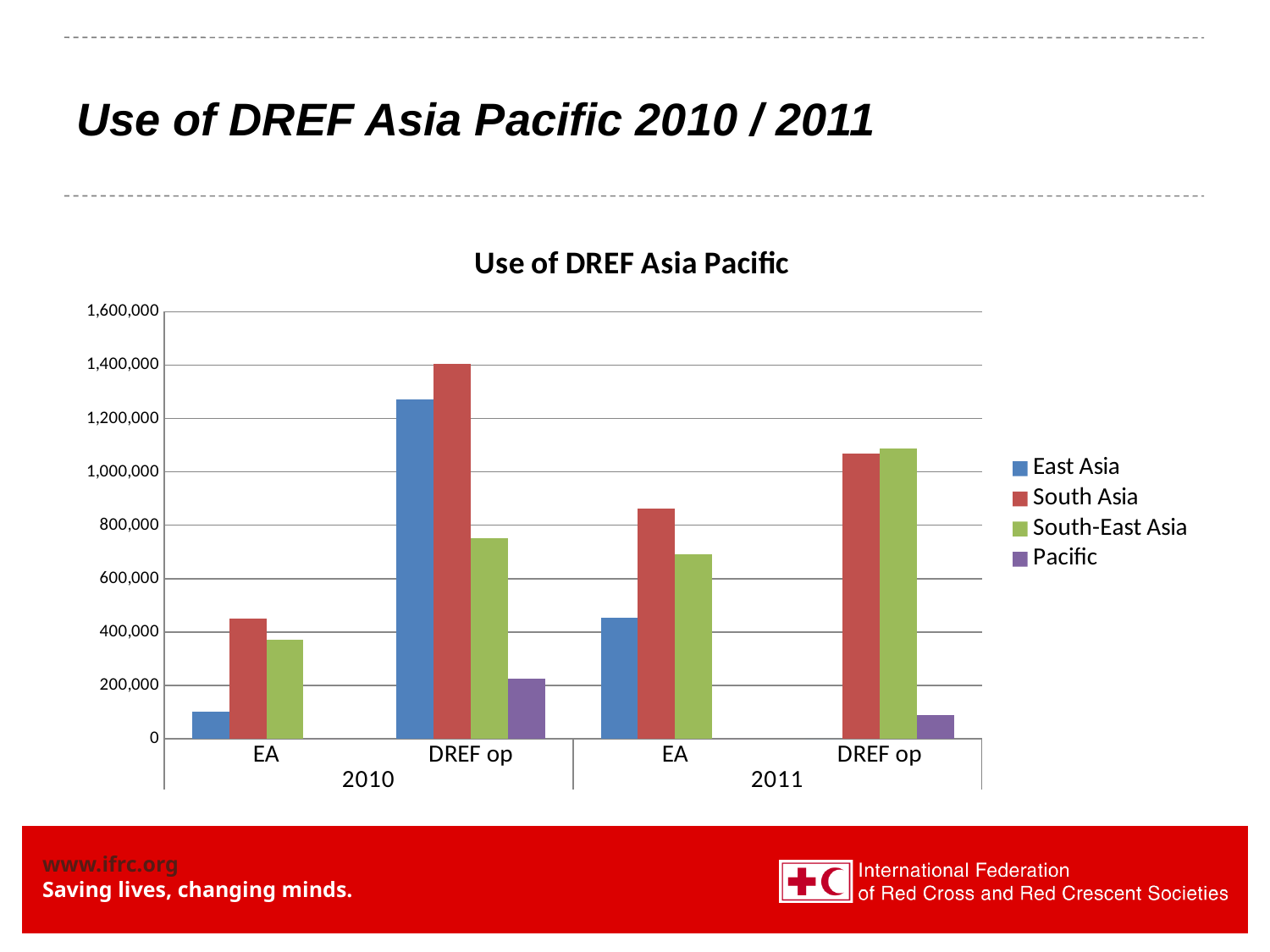
What colour represents the Pacific series in the legend? purple Which is larger for East Asia: the EA value in 2010 or the EA value in 2011? 2011 Is the value for South Asia under EA in 2010 greater or less than 400,000? greater How many category groups are shown along the x axis? 4 Which is larger for EA in 2011: South Asia or South-East Asia? South Asia Which series has the lowest value for DREF op in 2010? Pacific Is the value for East Asia under DREF op in 2010 greater or less than 1,200,000? greater Which series has the highest value for DREF op in 2010? South Asia How many series does the legend list? 4 Is the value for South Asia under DREF op in 2011 greater or less than 1,000,000? greater What kind of chart is shown on the slide? bar chart